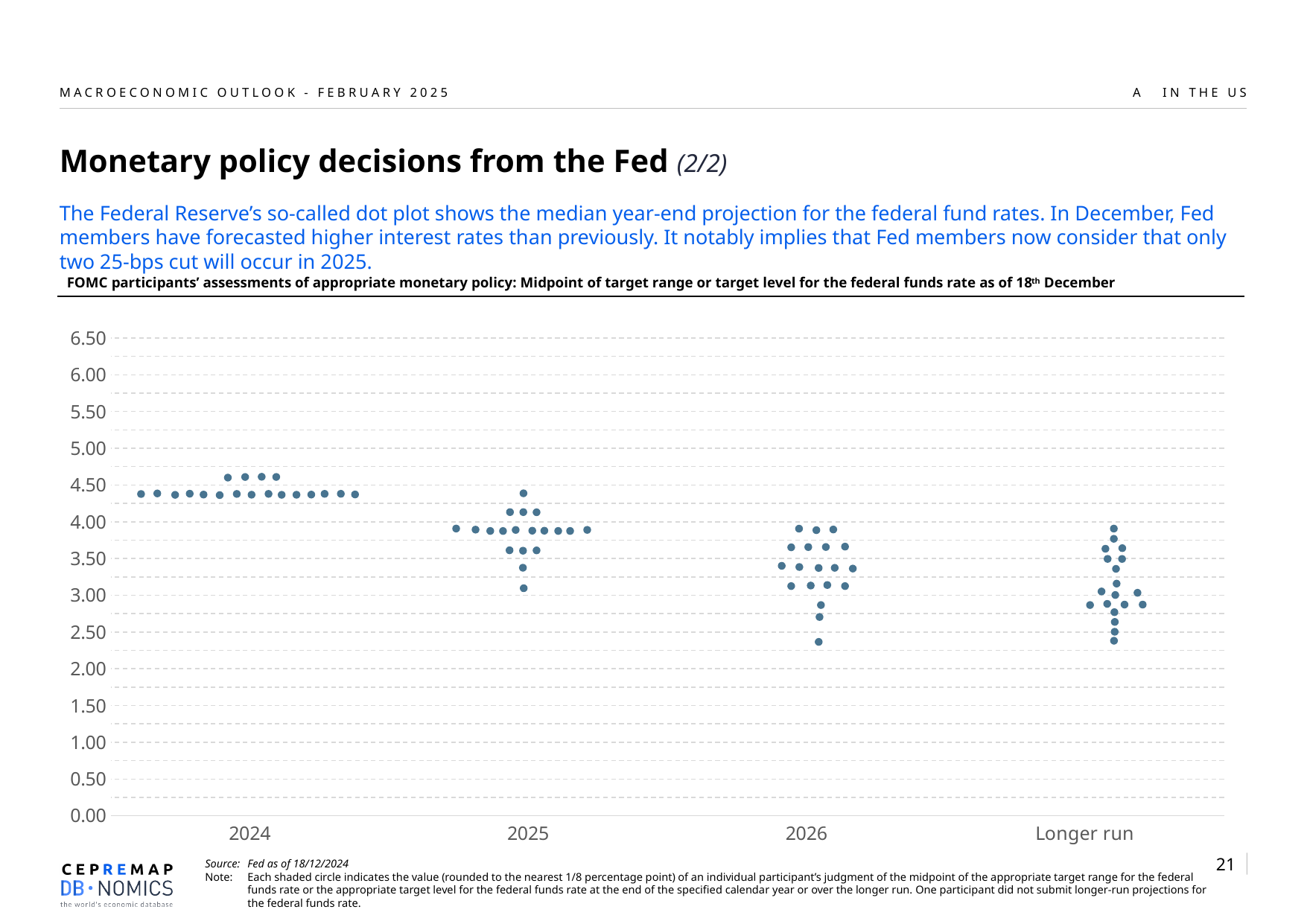
How many categories are shown along the x axis? 4 Are the values plotted for 2024 greater or less than 5.00? less Are the values plotted for 2026 greater or less than 4.00? less What is the last category label on the x axis? Longer run Do the plotted values rise or fall from 2024 to 2026? fall Are the values plotted for 2024 greater or less than 4.00? greater What is the highest value shown on the y axis? 6.50 What kind of chart is shown on the slide? Dot plot (scatter chart) Which category has higher plotted values, 2024 or 2026? 2024 Which category on the x axis has the highest plotted values? 2024